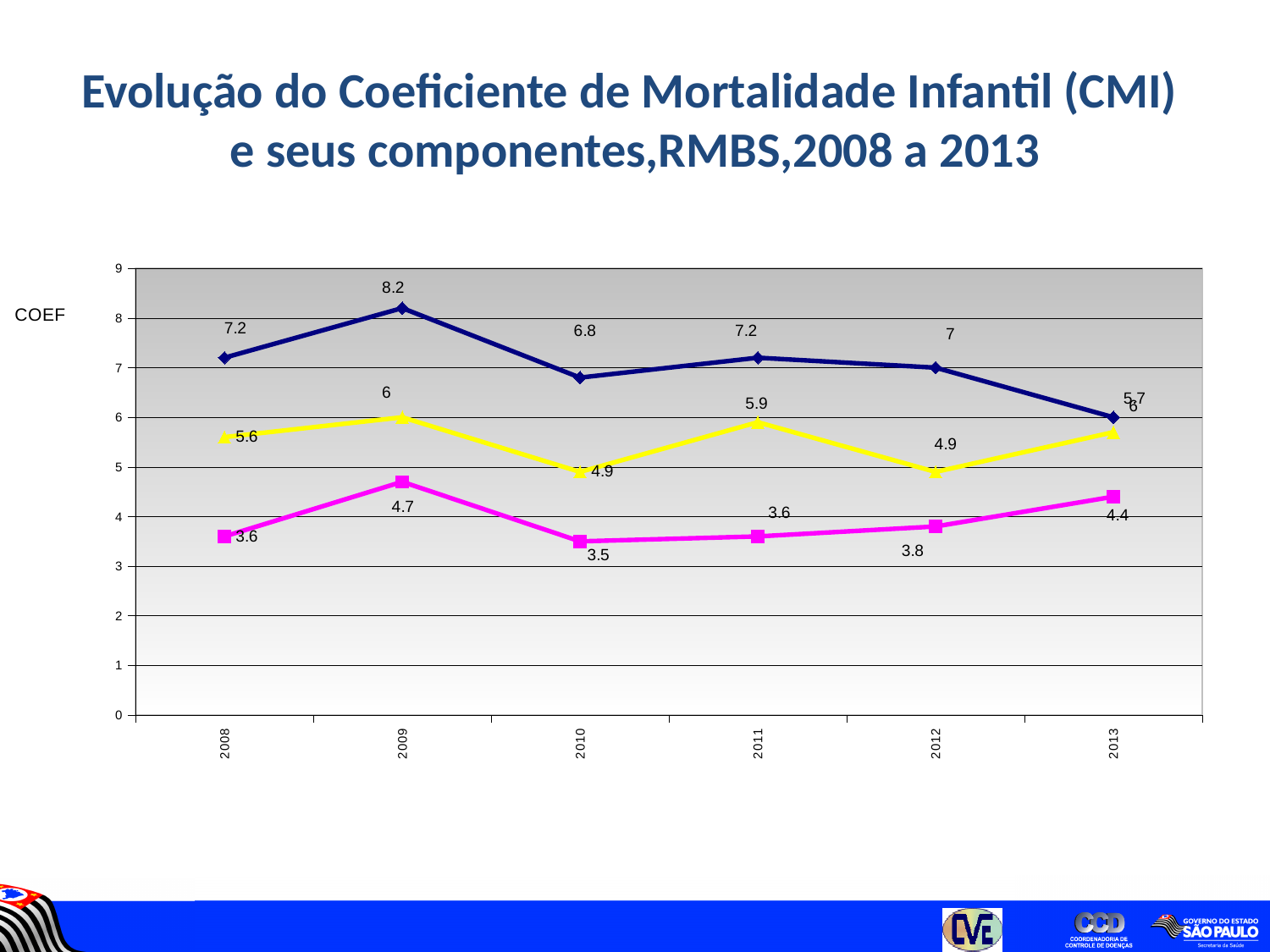
What label is shown on the vertical axis of the chart? COEF What is the value of the dark blue line in 2009? 8.2 In which year does the magenta line reach its lowest value? 2010 What is the difference between the dark blue line's value in 2009 and its value in 2010? 1.4 What is the value of the yellow line in 2011? 5.9 Does the magenta line rise or fall from 2010 to 2013? rise In which year does the dark blue line reach its highest value? 2009 What is the value of the magenta line in 2010? 3.5 Which is larger: the yellow line's value in 2009 or its value in 2012? 2009 How many years are plotted along the x axis? 6 What type of chart is shown on the slide? line chart Is the value of the dark blue line in 2012 greater or less than 6? greater